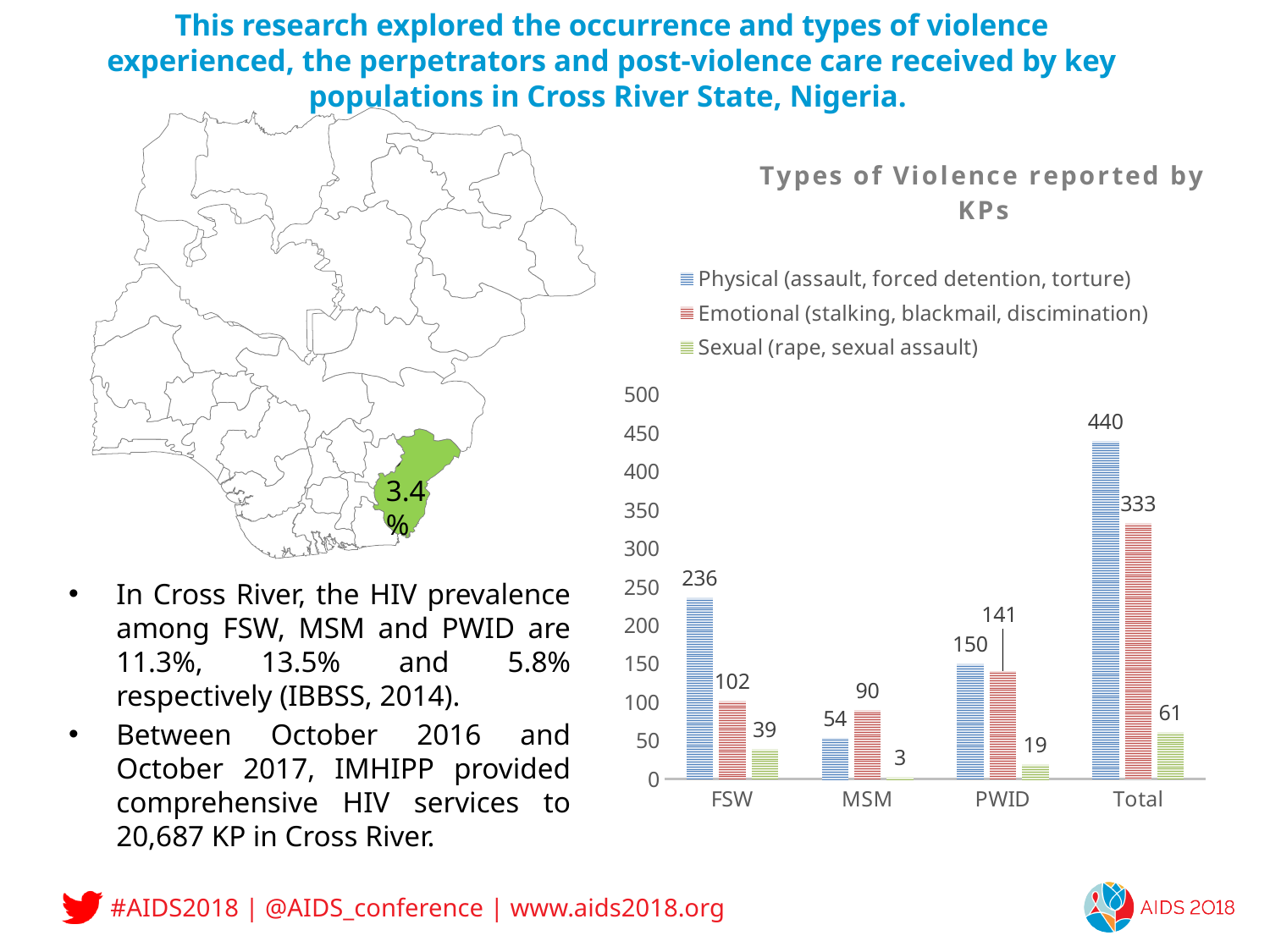
Is the Total value for Physical violence greater or less than 400? greater Which is larger for PWID: the Physical value or the Emotional value? Physical How many series does the legend list? 3 What type of chart is shown? bar chart What is the value for Emotional violence reported by MSM? 90 How many categories are shown on the x axis? 4 What is the value for Physical violence reported by FSW? 236 What is the difference between the Physical and Emotional values for FSW? 134 Which key population group has the lowest value for Sexual violence? MSM Among FSW, MSM and PWID, which group has the highest value for Physical violence? FSW What is the value for Sexual violence reported by PWID? 19 What is the Total value for Emotional violence? 333